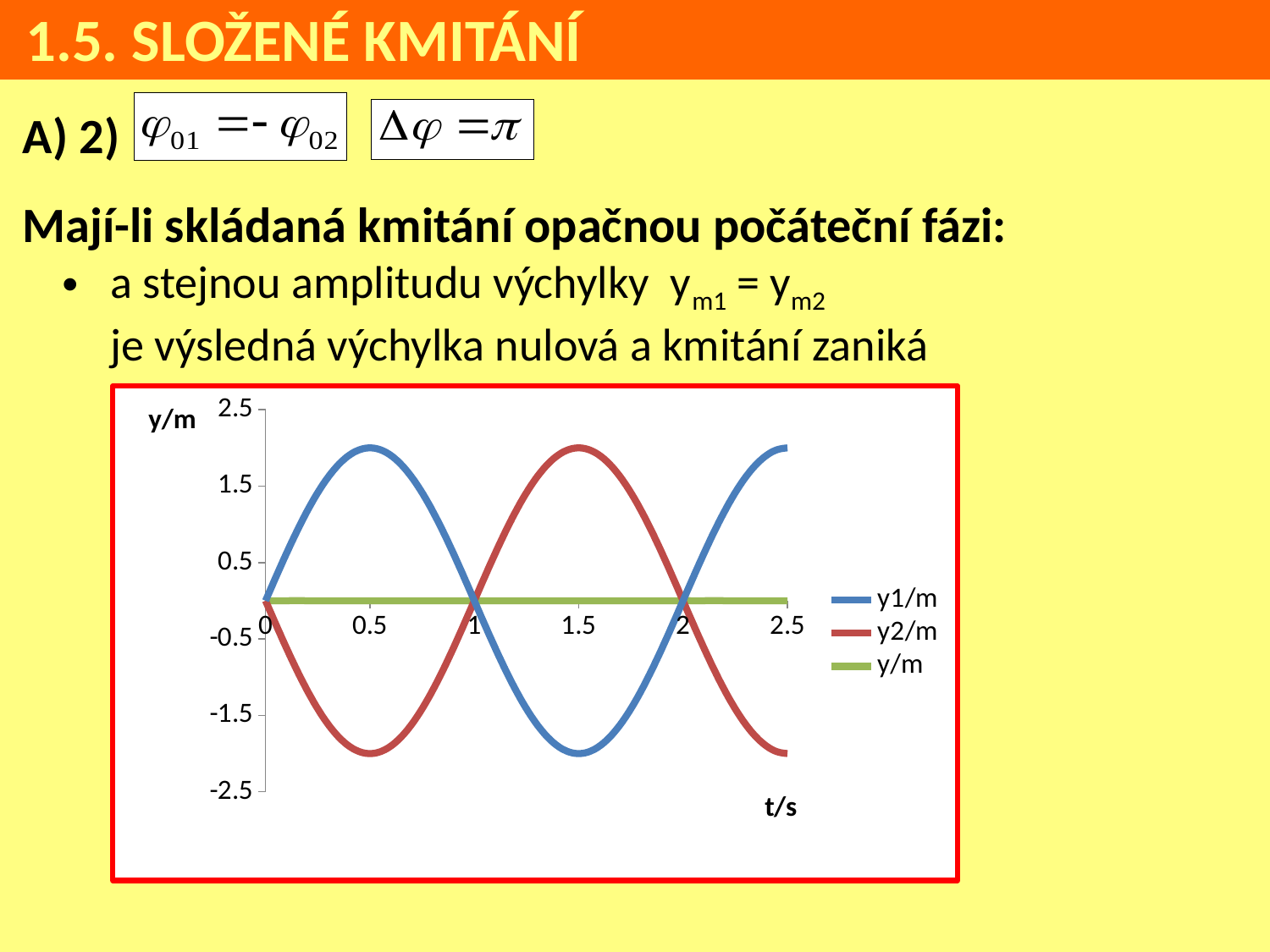
Is the value of y2/m at t = 0.5 greater or less than -1.5? less Is the value of y1/m at t = 0.5 greater or less than 1.5? greater Does the y2/m series rise or fall between t = 0.5 and t = 1.5? rise At t = 1.5, which series has the larger value, y1/m or y2/m? y2/m What are the names of the series listed in the chart legend? y1/m, y2/m, y/m At t = 0.5, which series has the larger value, y1/m or y2/m? y1/m Is the value of y2/m at t = 1.5 greater or less than 1.5? greater Does the y1/m series rise or fall between t = 0.5 and t = 1.5? fall What kind of chart is shown on the slide? line chart How many series does the chart legend list? 3 What is the label of the horizontal axis of the chart? t/s